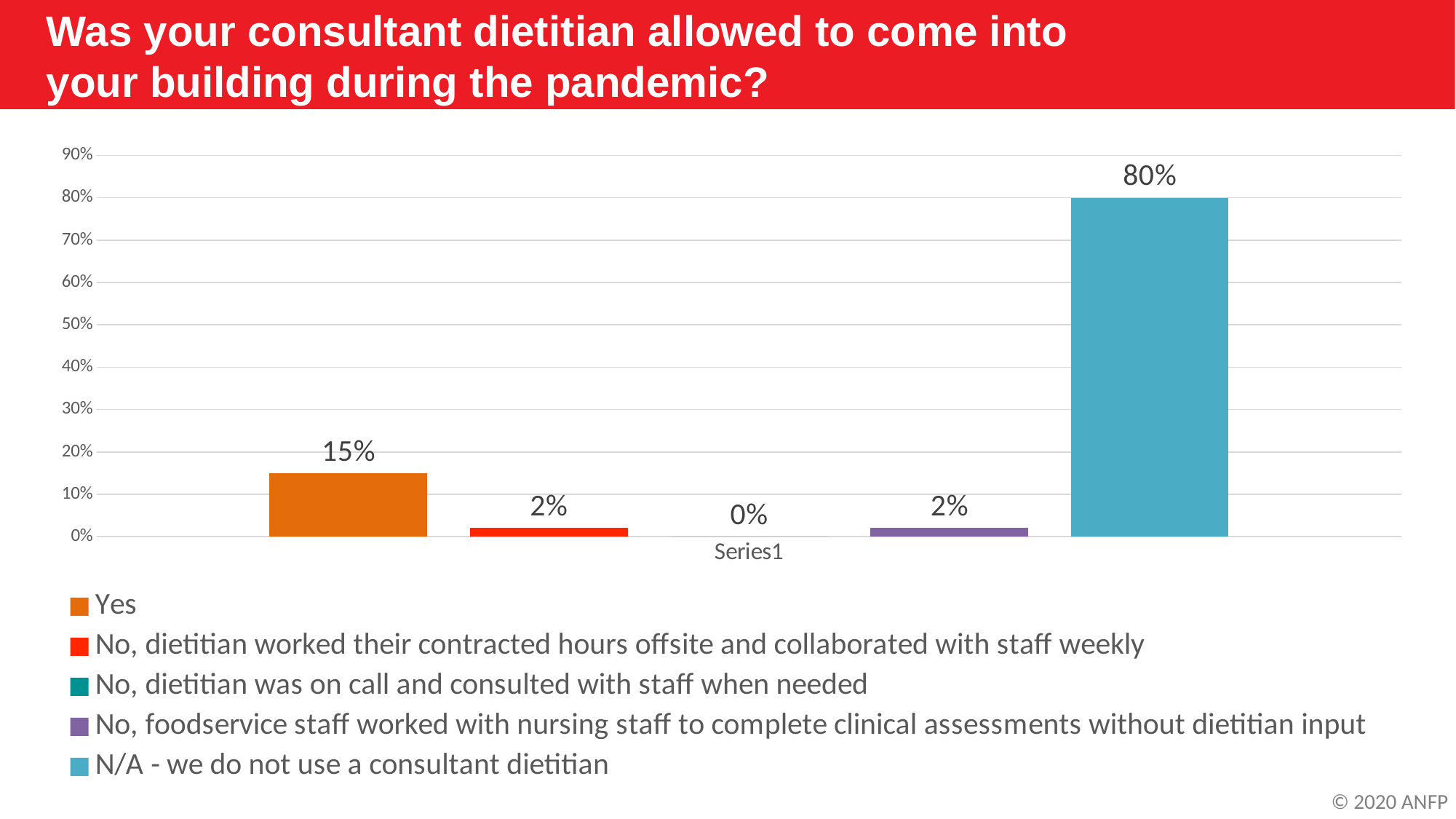
What percentage of respondents answered "Yes"? 15% Which response has the highest percentage? N/A - we do not use a consultant dietitian How many response categories does the legend list? 5 Which is larger: the percentage for "Yes" or for "No, dietitian worked their contracted hours offsite and collaborated with staff weekly"? Yes What is the highest value shown on the vertical axis? 90% What is the difference in percentage points between "N/A - we do not use a consultant dietitian" and "Yes"? 65 percentage points What colour is the bar for "Yes"? Orange What percentage of respondents answered "No, foodservice staff worked with nursing staff to complete clinical assessments without dietitian input"? 2% What kind of chart is shown on the slide? Bar chart What percentage of respondents answered "No, dietitian was on call and consulted with staff when needed"? 0% Which response has the lowest percentage? No, dietitian was on call and consulted with staff when needed What percentage of respondents answered "N/A - we do not use a consultant dietitian"? 80%